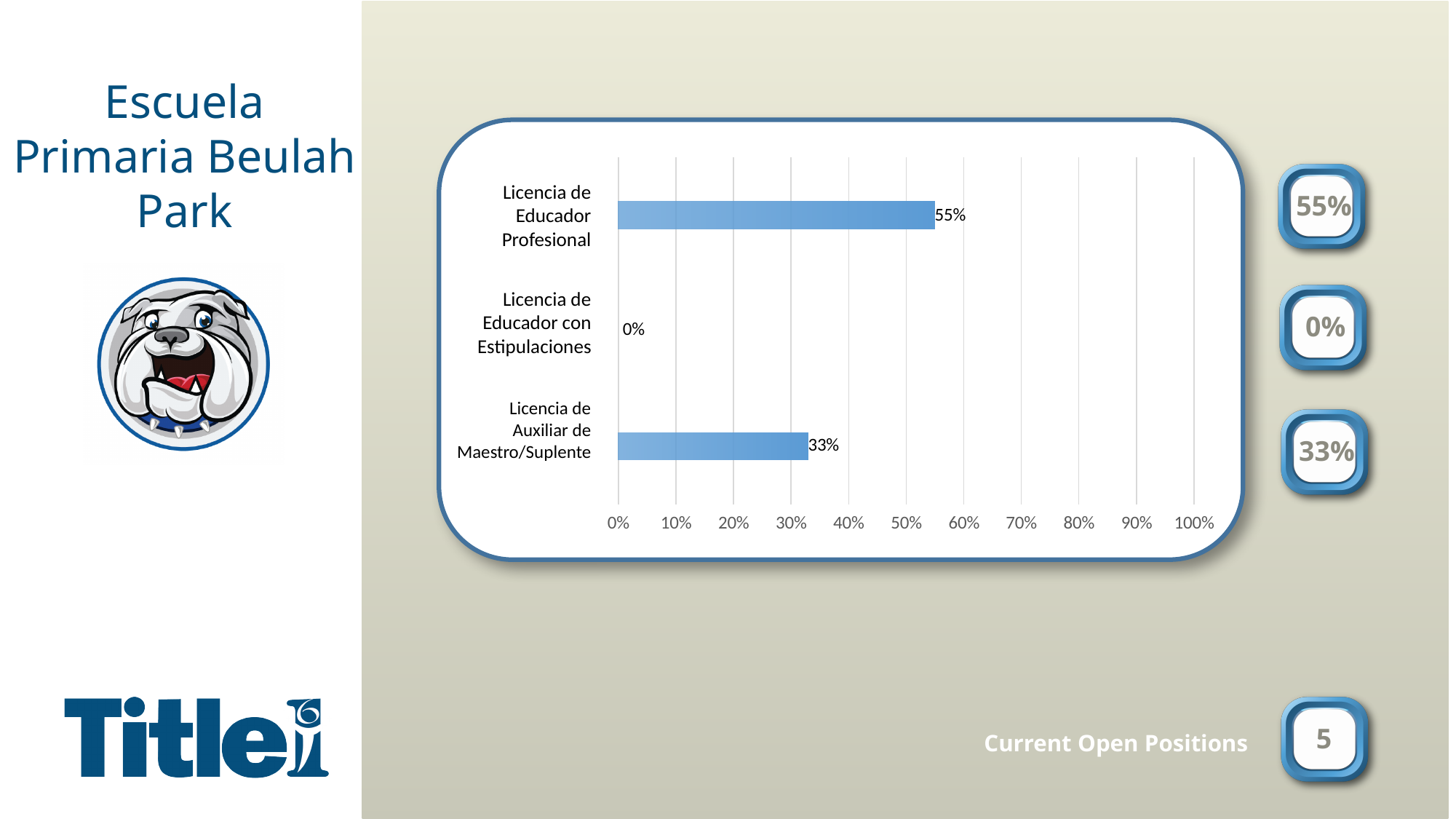
Which category has the highest value? Licencia de Educador Profesional What is the value for Licencia de Auxiliar de Maestro/Suplente? 33% Which category has the lowest value? Licencia de Educador con Estipulaciones Which is larger, the value for Licencia de Educador Profesional or the value for Licencia de Auxiliar de Maestro/Suplente? Licencia de Educador Profesional What is the difference between the values for Licencia de Educador Profesional and Licencia de Auxiliar de Maestro/Suplente? 22% What is the value for Licencia de Educador con Estipulaciones? 0% What is the maximum value shown on the horizontal axis of the chart? 100% How many categories are shown in the chart? 3 What kind of chart is shown on the slide? bar chart Is the value for Licencia de Auxiliar de Maestro/Suplente greater or less than 40%? less Is the value for Licencia de Educador Profesional greater or less than 50%? greater What is the value for Licencia de Educador Profesional? 55%